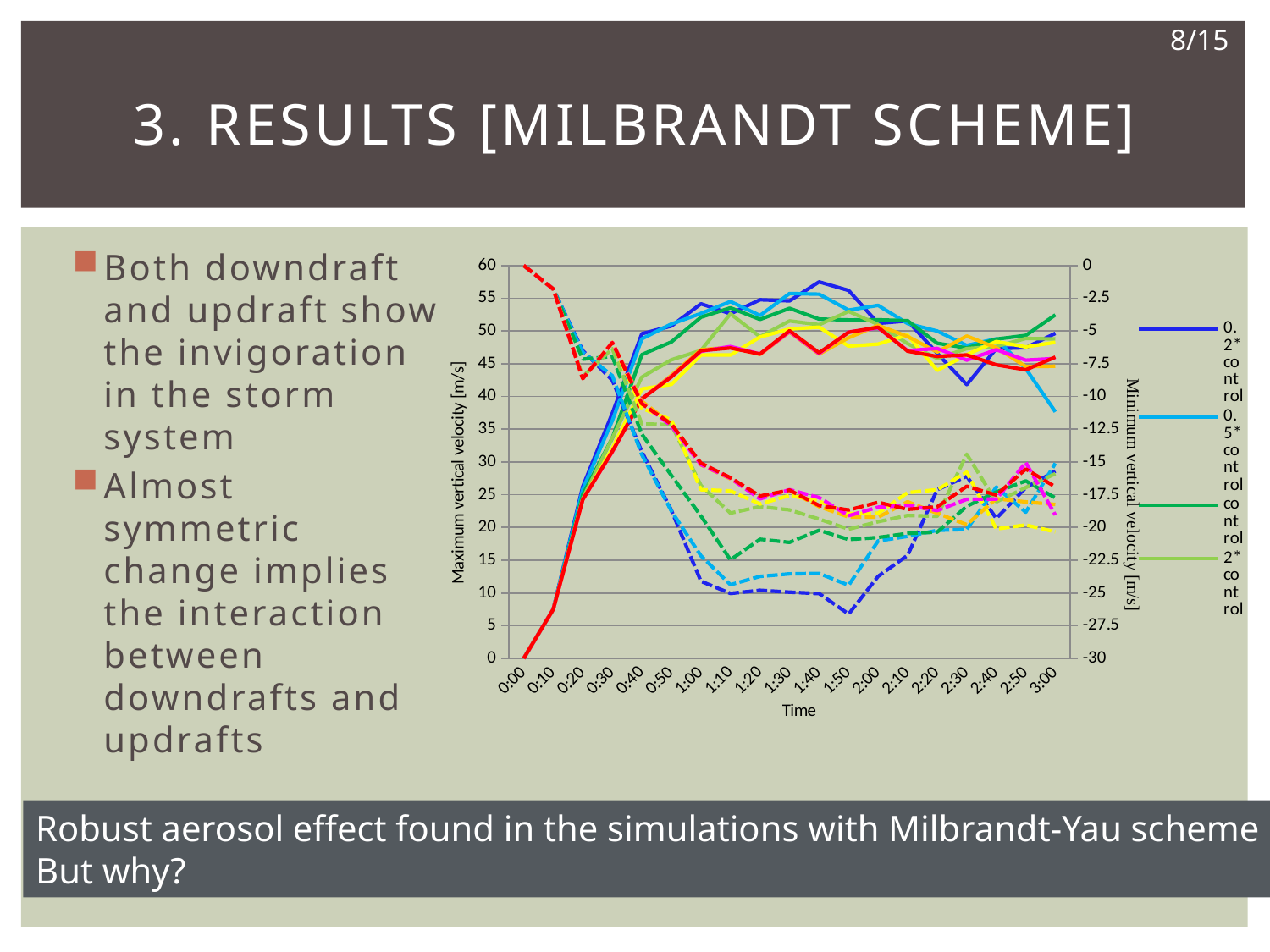
What kind of chart is shown on the slide? Line chart What is the highest value shown on the left y axis of the chart? 60 Which solid line has the lowest value at 3:00 on the chart? The light blue line (0.5*control) Which solid line reaches the highest peak on the chart? The dark blue line (0.2*control) How many entries does the chart's legend list? 4 Do the solid lines rise or fall between 0:00 and 0:50 on the chart? Rise How many time points are labelled along the x axis of the chart? 19 What is the label of the x axis of the chart? Time Is the value of the solid dark blue line at 1:40 greater or less than 50 on the left axis? greater What is the lowest value shown on the right y axis of the chart? -30 What is the label of the left y axis of the chart? Maximum vertical velocity [m/s] Is the value of the solid red line at 1:00 greater or less than 40 on the left axis? greater